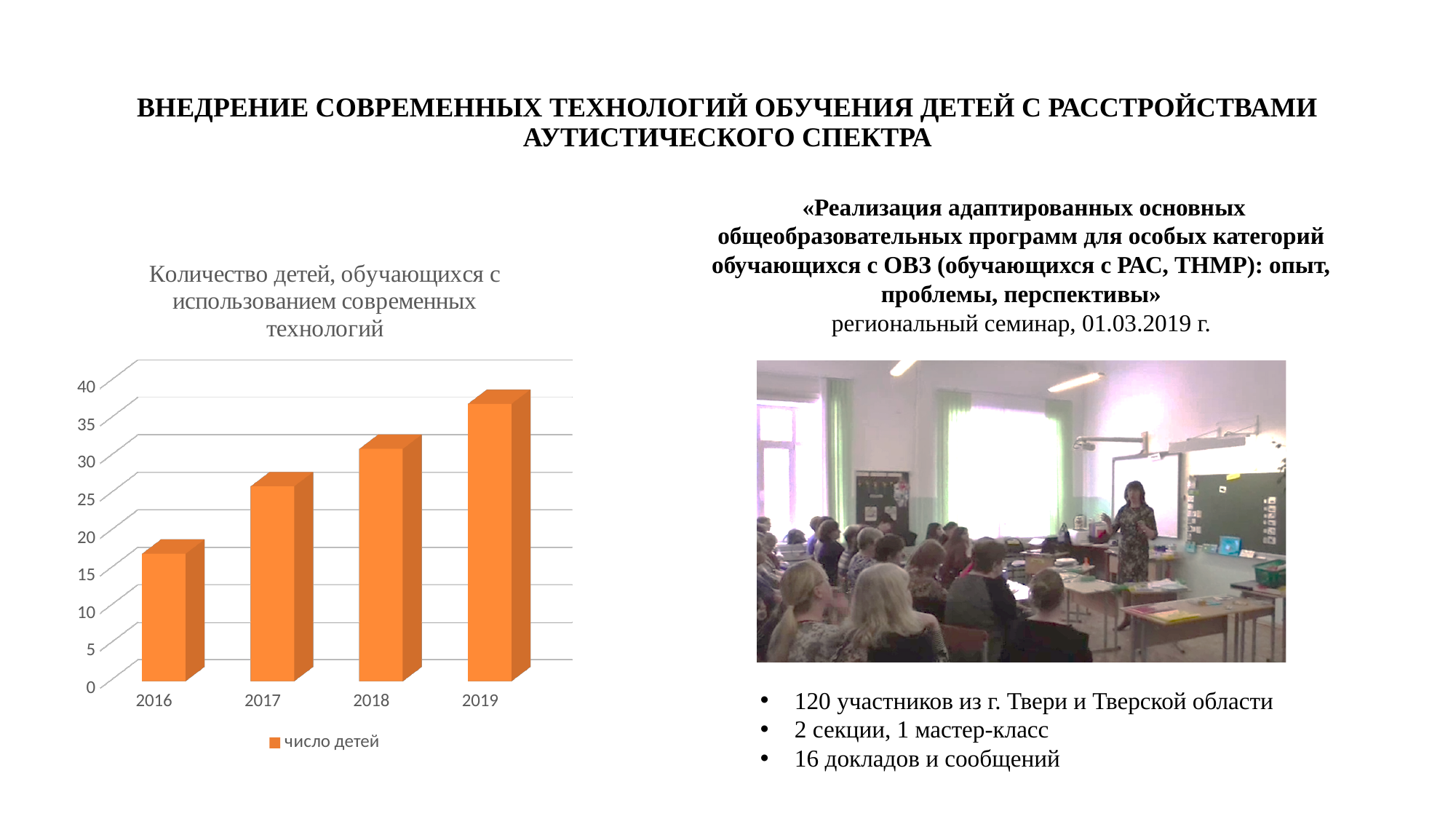
What is the name of the series in the chart legend? число детей Which year has the highest number of children in the chart? 2019 How many years (categories) are shown on the x axis of the chart? 4 How many series does the chart legend list? 1 Is the value for 2018 greater or less than 25? greater Is the value for 2016 greater or less than 20? less What is the title of the chart? Количество детей, обучающихся с использованием современных технологий What kind of chart is shown on the slide? bar chart Is the value for 2019 greater or less than 30? greater Which is larger in the chart, the value for 2017 or the value for 2018? 2018 Which year has the lowest number of children in the chart? 2016 Do the values in the chart rise or fall from 2016 to 2019? rise